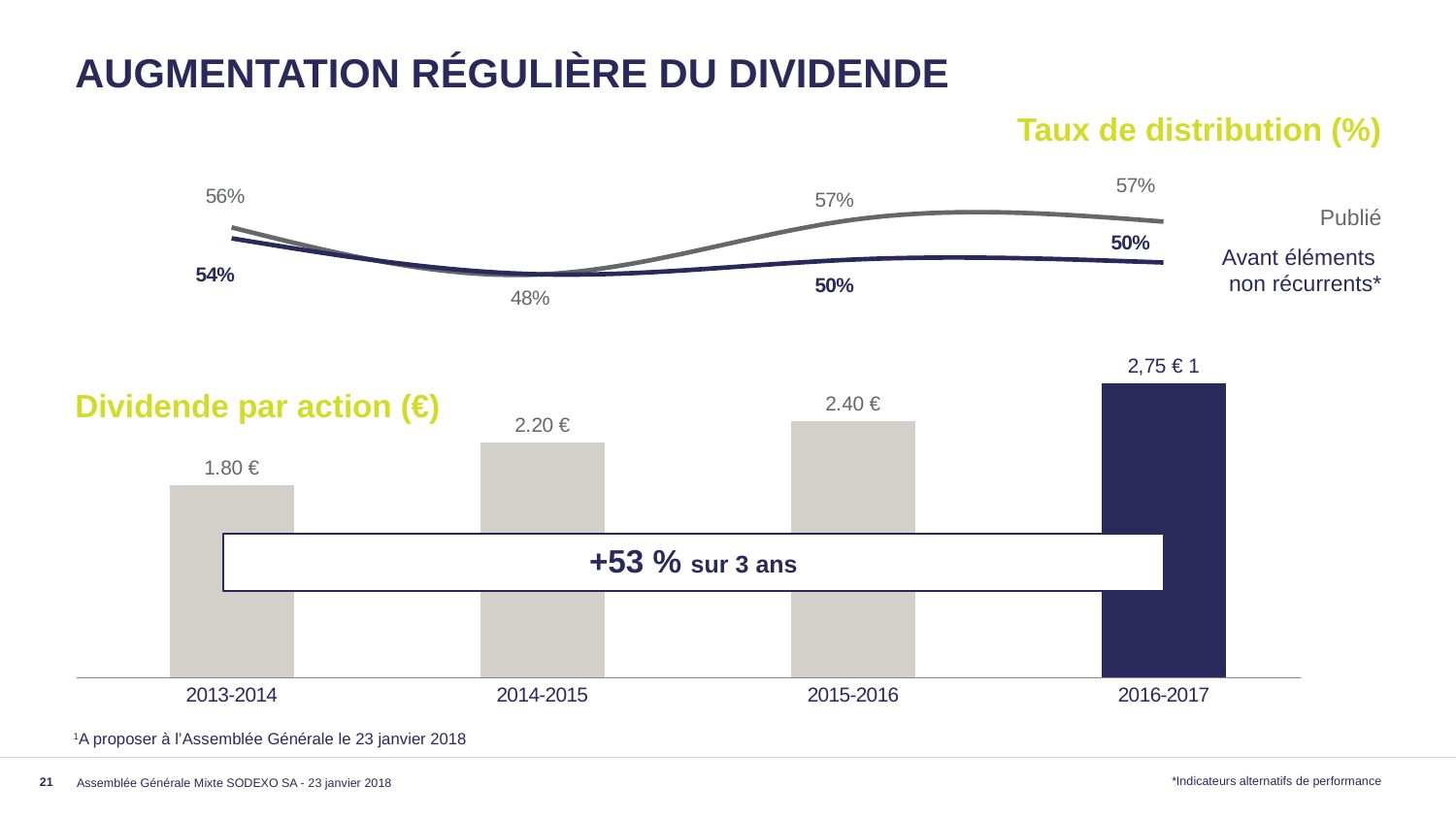
In the 'Dividende par action (€)' chart, do the values rise or fall from 2013-2014 to 2016-2017? rise In the 'Dividende par action (€)' chart, what is the dividend per share for 2016-2017? 2,75 € In the 'Dividende par action (€)' chart, what is the dividend per share for 2013-2014? 1.80 € In the 'Taux de distribution (%)' chart, how many series are shown? 2 In the 'Dividende par action (€)' chart, which year has the highest dividend per share? 2016-2017 In the 'Taux de distribution (%)' chart, what is the 'Avant éléments non récurrents' value for 2013-2014? 54% In the 'Dividende par action (€)' chart, what is the difference between the dividend for 2015-2016 and 2014-2015? 0.20 € In the 'Taux de distribution (%)' chart, what is the 'Publié' value for 2014-2015? 48% In the 'Taux de distribution (%)' chart, which is larger for 2016-2017: 'Publié' or 'Avant éléments non récurrents'? Publié What kind of chart is 'Dividende par action (€)'? bar chart In the 'Dividende par action (€)' chart, which year has the lowest dividend per share? 2013-2014 In the 'Dividende par action (€)' chart, how many years are shown? 4